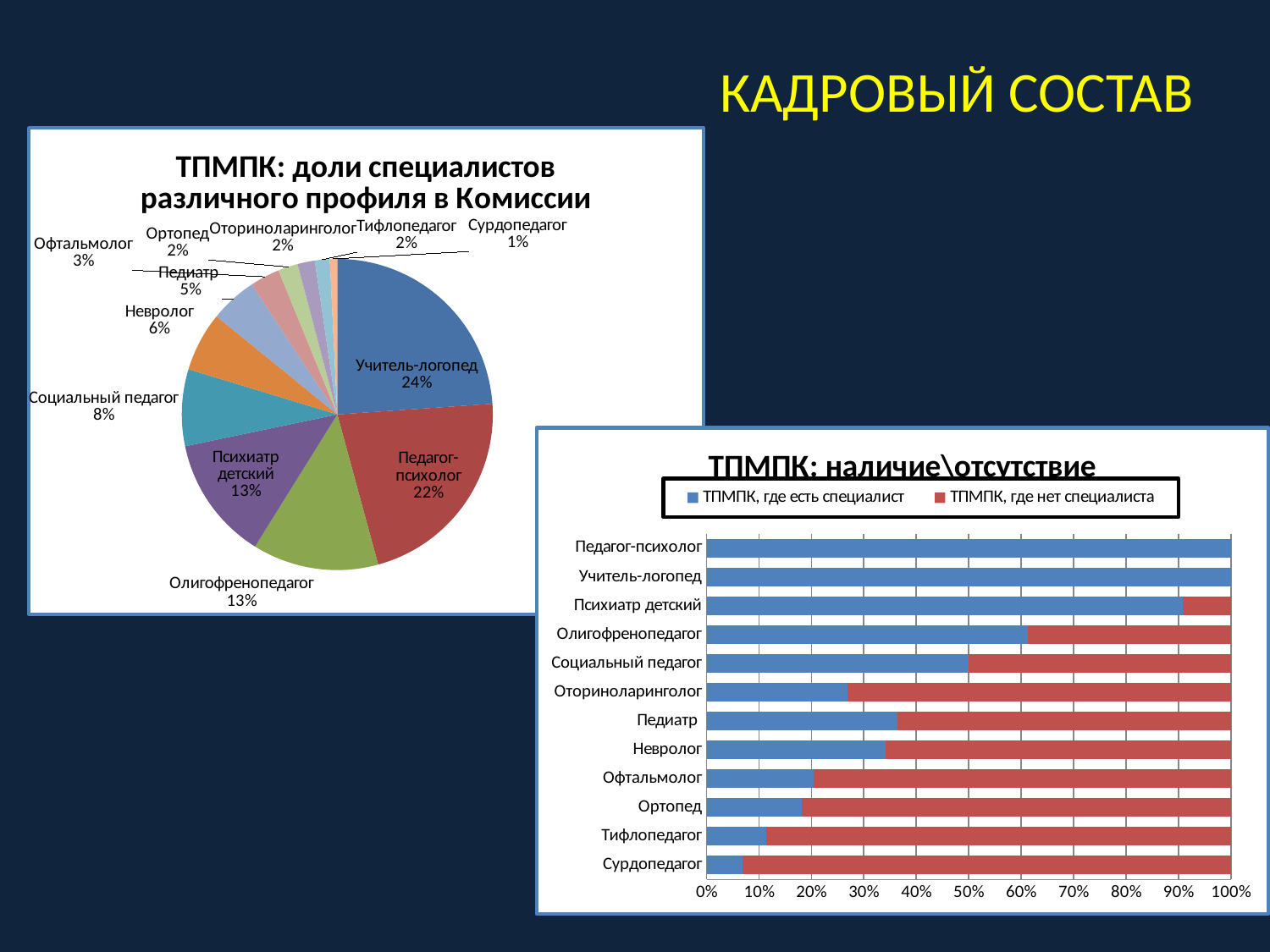
On the pie chart 'ТПМПК: доли специалистов различного профиля в Комиссии', which category has the largest share? Учитель-логопед On the chart 'ТПМПК: наличие\отсутствие', which colour represents 'ТПМПК, где нет специалиста'? Red On the pie chart 'ТПМПК: доли специалистов различного профиля в Комиссии', how many categories are shown? 12 On the pie chart 'ТПМПК: доли специалистов различного профиля в Комиссии', what share does Учитель-логопед have? 24% On the chart 'ТПМПК: наличие\отсутствие', how many series does the legend list? 2 What kind of chart is 'ТПМПК: наличие\отсутствие'? Bar chart On the pie chart 'ТПМПК: доли специалистов различного профиля в Комиссии', which category has the smallest share? Сурдопедагог On the pie chart 'ТПМПК: доли специалистов различного профиля в Комиссии', which is larger: the share of Невролог or the share of Педиатр? Невролог On the chart 'ТПМПК: наличие\отсутствие', is the value of 'ТПМПК, где есть специалист' for Сурдопедагог greater or less than 10%? less On the chart 'ТПМПК: наличие\отсутствие', is the value of 'ТПМПК, где есть специалист' for Педиатр greater or less than 30%? greater On the pie chart 'ТПМПК: доли специалистов различного профиля в Комиссии', what share does Педагог-психолог have? 22% On the pie chart 'ТПМПК: доли специалистов различного профиля в Комиссии', what is the difference between the shares of Учитель-логопед and Социальный педагог? 16%